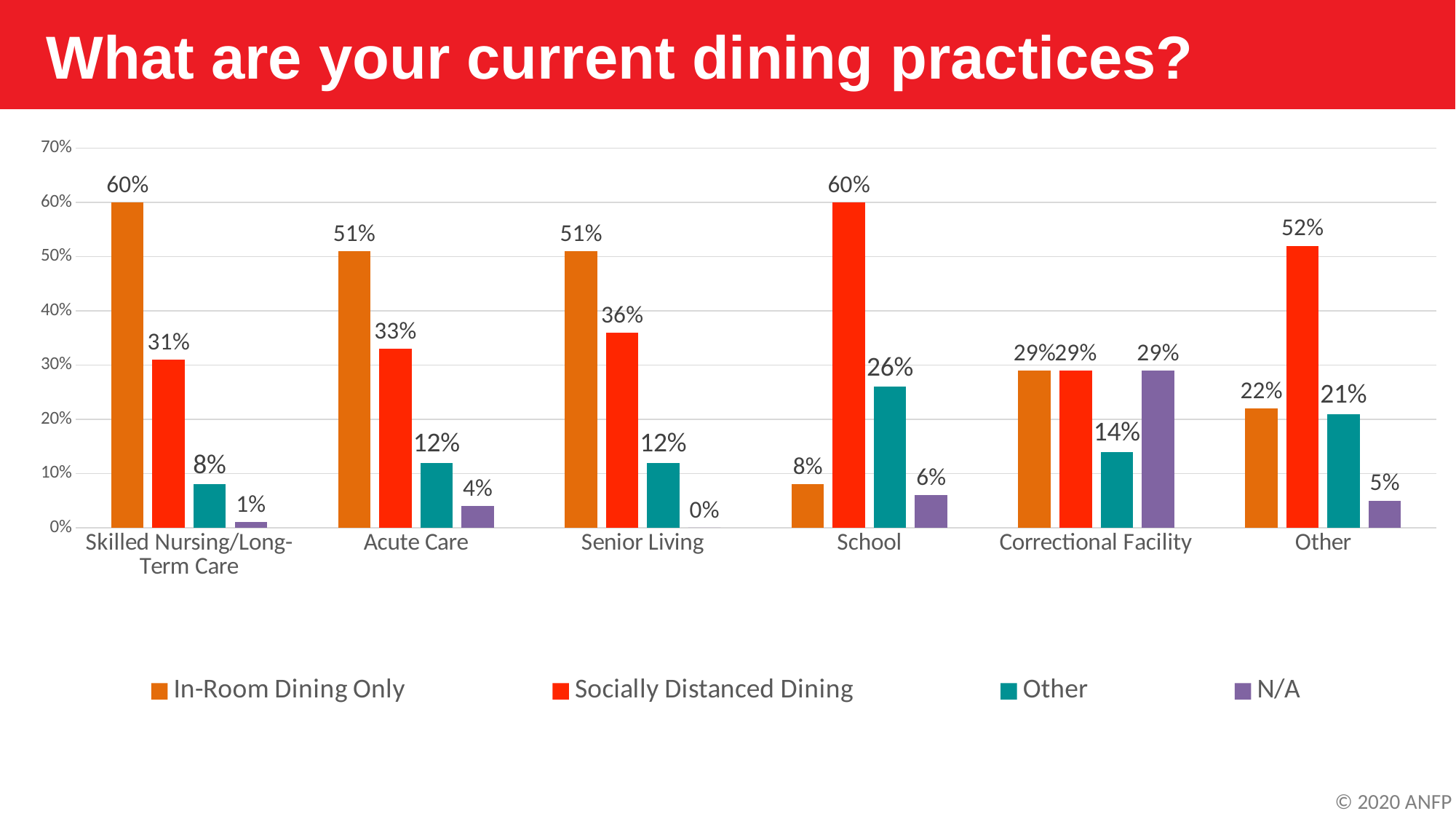
What is the title of the slide? What are your current dining practices? What is the value for In-Room Dining Only in the Skilled Nursing/Long-Term Care category? 60% What is the difference between In-Room Dining Only and Socially Distanced Dining in the Acute Care category? 18% How many categories are shown on the x axis? 6 Which category has the lowest value for In-Room Dining Only? School What is the value for Other in the Correctional Facility category? 14% Which category has the highest value for Socially Distanced Dining? School How many series does the legend list? 4 What is the value for Socially Distanced Dining in the School category? 60% What is the value for N/A in the Senior Living category? 0% Which is larger in the Other category: Socially Distanced Dining or In-Room Dining Only? Socially Distanced Dining What kind of chart is shown on the slide? Bar chart